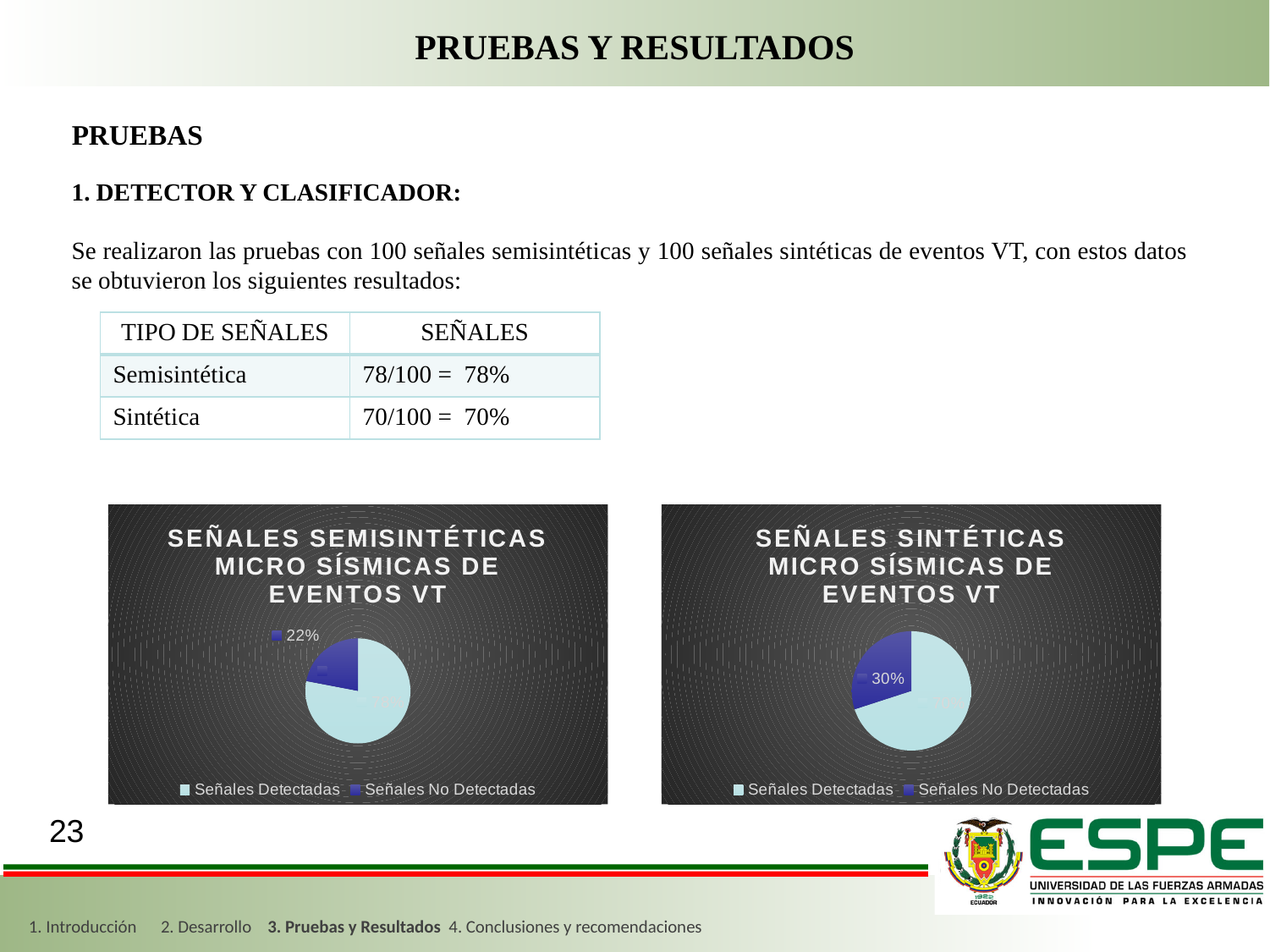
How many slices does the left pie chart (Señales Semisintéticas) have? 2 What kind of chart is used on the right side of the slide? Pie chart Which chart shows a larger share of Señales No Detectadas, the left (Semisintéticas) or the right (Sintéticas)? The right (Sintéticas) In the left pie chart (Señales Semisintéticas), what percentage is shown for Señales No Detectadas? 22% In the right pie chart (Señales Sintéticas), which category has the smallest slice? Señales No Detectadas What are the two legend entries of the right pie chart (Señales Sintéticas)? Señales Detectadas and Señales No Detectadas What is the title of the left pie chart? SEÑALES SEMISINTÉTICAS MICRO SÍSMICAS DE EVENTOS VT How many entries does the legend of the right pie chart (Señales Sintéticas) list? 2 In the right pie chart (Señales Sintéticas), is the slice for Señales Detectadas larger or smaller than the slice for Señales No Detectadas? Larger In the left pie chart (Señales Semisintéticas), which category has the largest slice? Señales Detectadas In the right pie chart (Señales Sintéticas), what percentage is shown for Señales No Detectadas? 30% What kind of chart is used on the left side of the slide? Pie chart